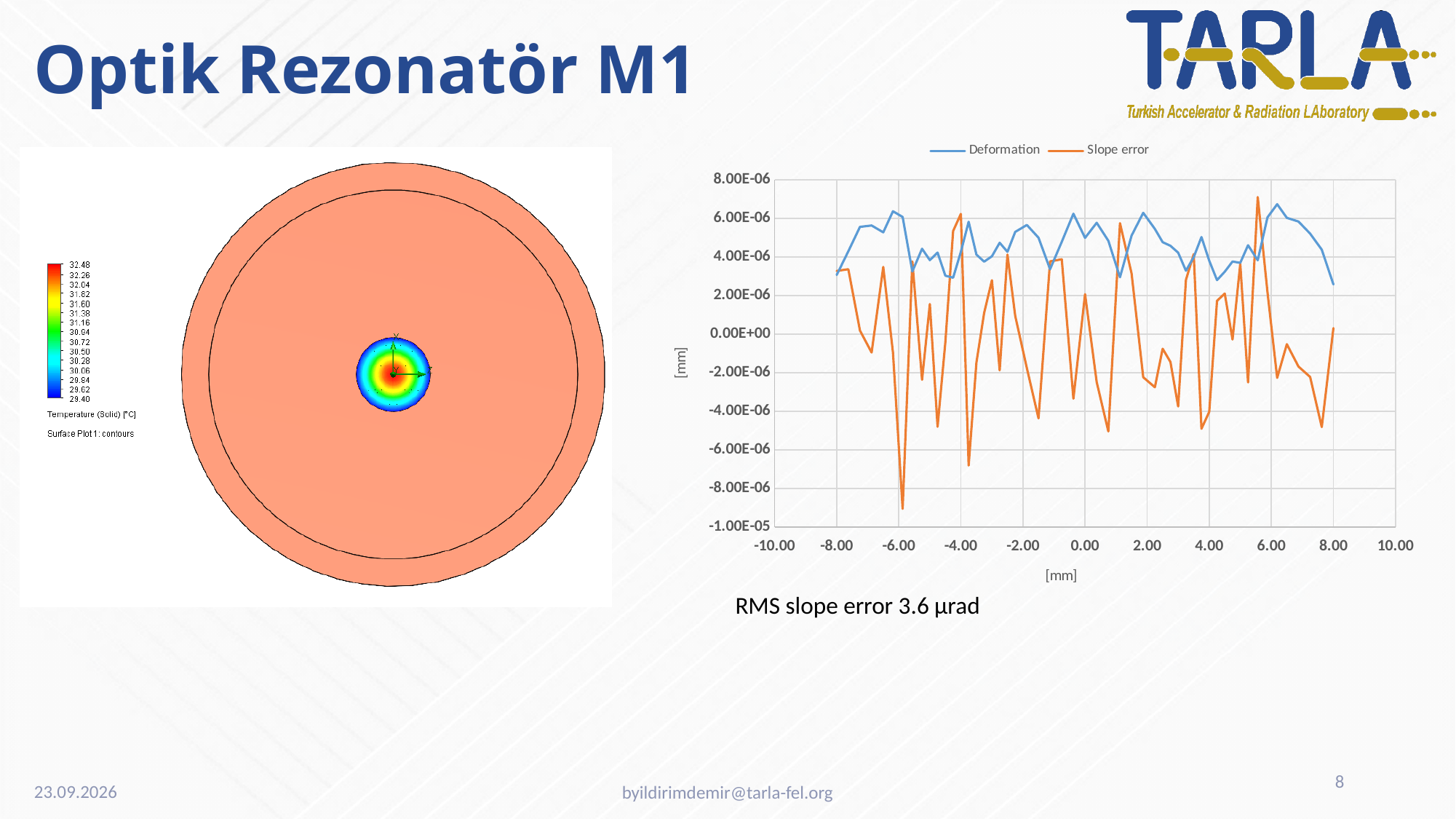
How many series does the legend of the line chart list? 2 In the line chart, which colour is used for the Slope error series? orange In the line chart, which series reaches the lowest value? Slope error In the line chart, is the Deformation value at x = 8.00 greater or less than 4.00E-06? less In the line chart, does the Deformation series ever drop below 0.00E+00? No In the line chart, is the Deformation value at x = -6.00 greater or less than 4.00E-06? greater What kind of chart is shown on the right of the slide? line chart What is the label on the x axis of the line chart? [mm] In the line chart, at x = -4.00, which series has the larger value, Deformation or Slope error? Slope error What is the lowest value shown on the y axis of the line chart? -1.00E-05